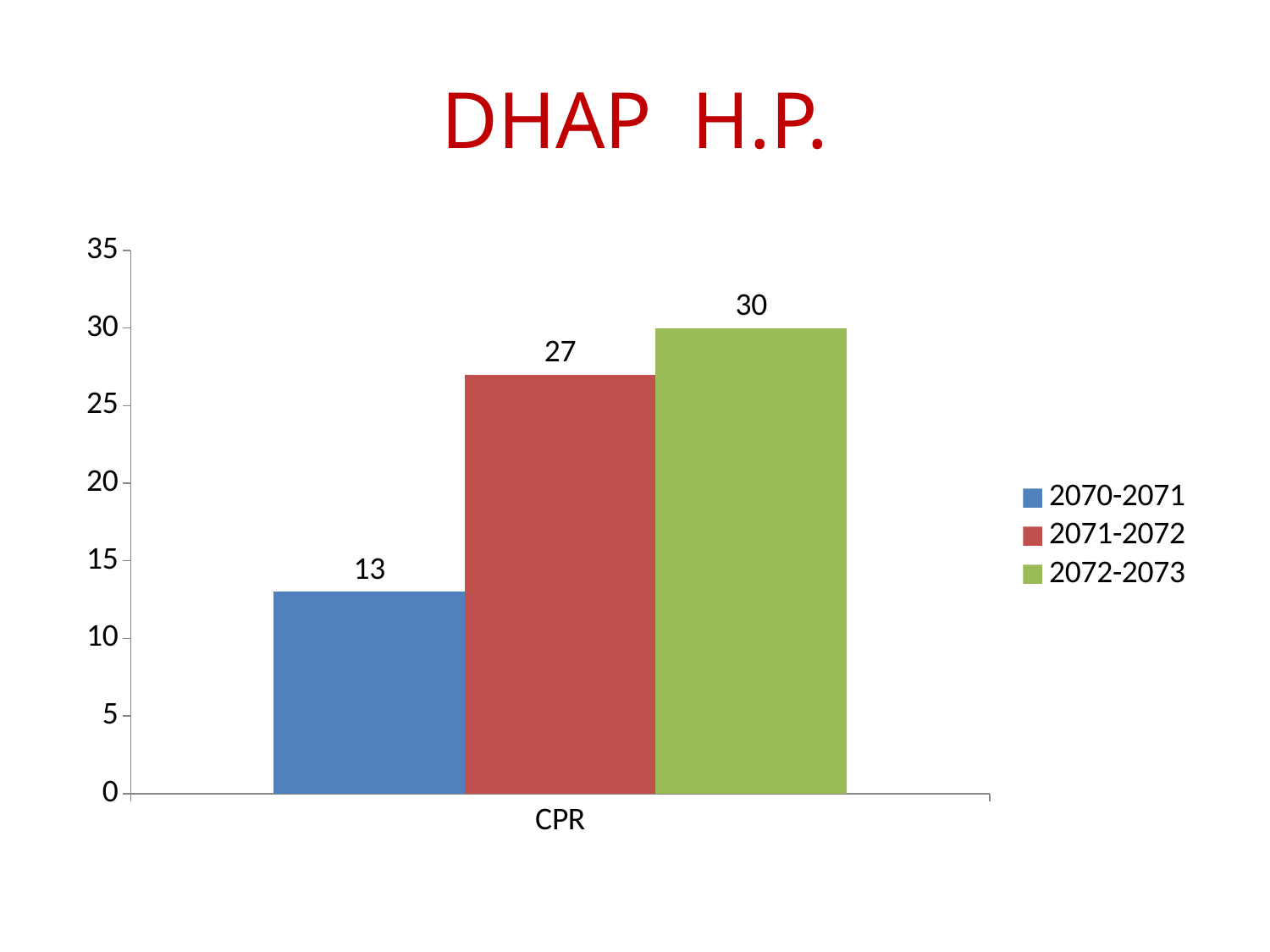
What is the CPR value for 2072-2073? 30 What is the difference between the CPR values for 2071-2072 and 2070-2071? 14 What kind of chart is shown on the slide? bar chart What is the CPR value for 2070-2071? 13 Which series has the lowest CPR value? 2070-2071 Which is larger, the CPR value for 2071-2072 or for 2072-2073? 2072-2073 What is the CPR value for 2071-2072? 27 Is the CPR value for 2070-2071 greater or less than 15? less What is the difference between the CPR values for 2072-2073 and 2070-2071? 17 Which series has the highest CPR value? 2072-2073 What is the title of the slide? DHAP H.P. How many series does the legend list? 3